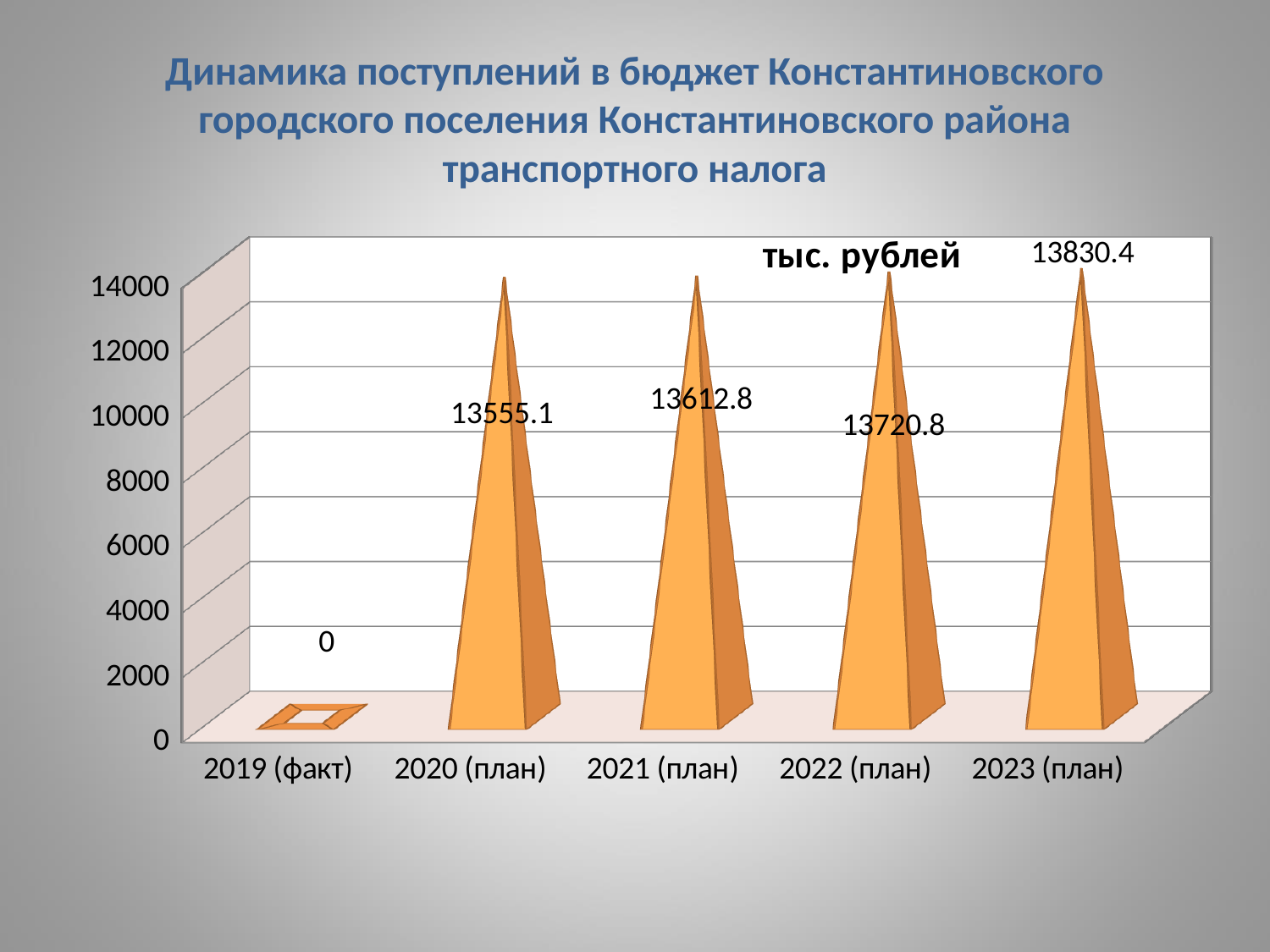
Do the values rise or fall from 2020 (план) to 2023 (план)? rise Which is larger, the value for 2021 (план) or the value for 2022 (план)? 2022 (план) What is the difference between the values for 2023 (план) and 2020 (план)? 275.3 Which category has the highest value? 2023 (план) What is the value for 2019 (факт)? 0 Is the value for 2020 (план) greater or less than 12000? greater How many categories are shown on the x axis? 5 What is the value for 2020 (план)? 13555.1 What is the difference between the values for 2022 (план) and 2021 (план)? 108 Which category has the lowest value? 2019 (факт) What is the value for 2022 (план)? 13720.8 What is the value for 2023 (план)? 13830.4